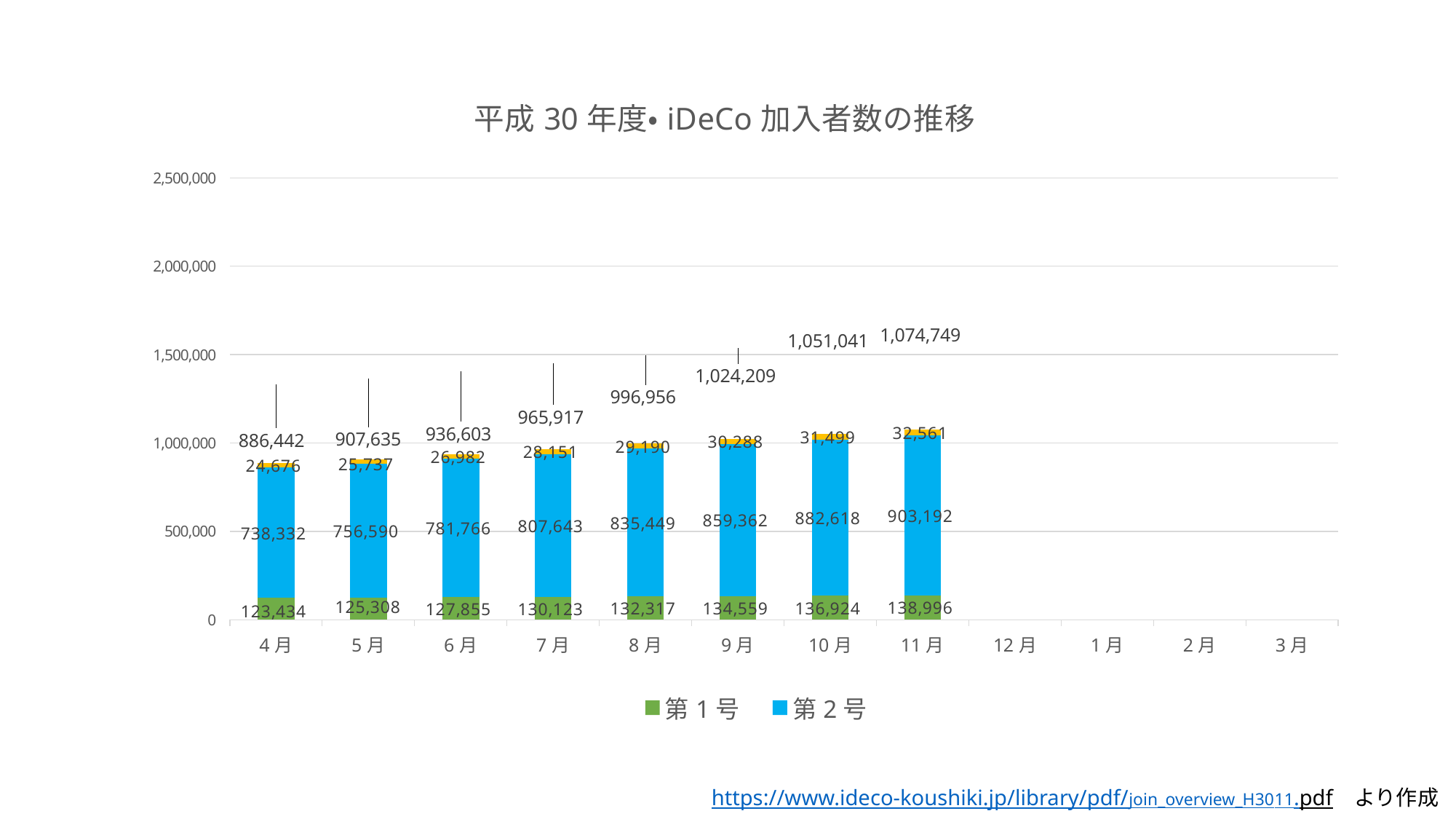
Do the total subscriber numbers rise or fall from 4月 to 11月? Rise What is the value of 第2号 for 7月? 807,643 What is the difference between the 第1号 value for 10月 and the 第1号 value for 9月? 2,365 What is the difference between the 第2号 value for 11月 and the 第2号 value for 4月? 164,860 Which is larger: the total for 6月 or the total for 7月? 7月 What is the value of 第1号 for 11月? 138,996 Which month has the highest total number of subscribers? 11月 What kind of chart is shown on the slide? Stacked bar chart How many series does the legend list? 2 What is the total labeled above the bar for 9月? 1,024,209 How many month categories are shown on the x axis? 12 Which month has the lowest value for 第1号? 4月